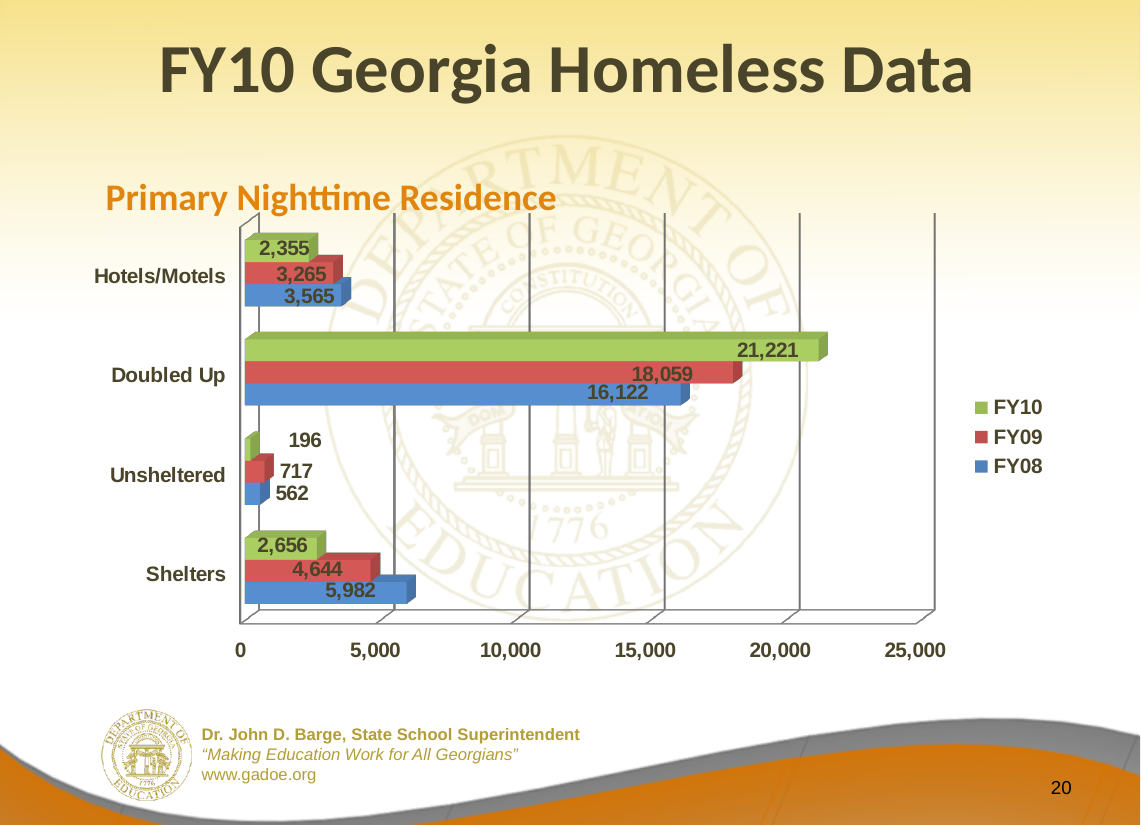
How many series does the legend list? 3 Which is larger for Shelters, the FY09 value or the FY10 value? FY09 What is the FY10 value for Doubled Up? 21,221 Which category has the highest FY10 value? Doubled Up What kind of chart is shown on the slide? Bar chart What is the title of the chart? Primary Nighttime Residence What is the FY10 value for Unsheltered? 196 What is the FY09 value for Hotels/Motels? 3,265 What is the difference between the FY10 and FY08 values for Doubled Up? 5,099 How many categories are shown on the chart? 4 What is the FY08 value for Shelters? 5,982 Which category has the lowest FY09 value? Unsheltered